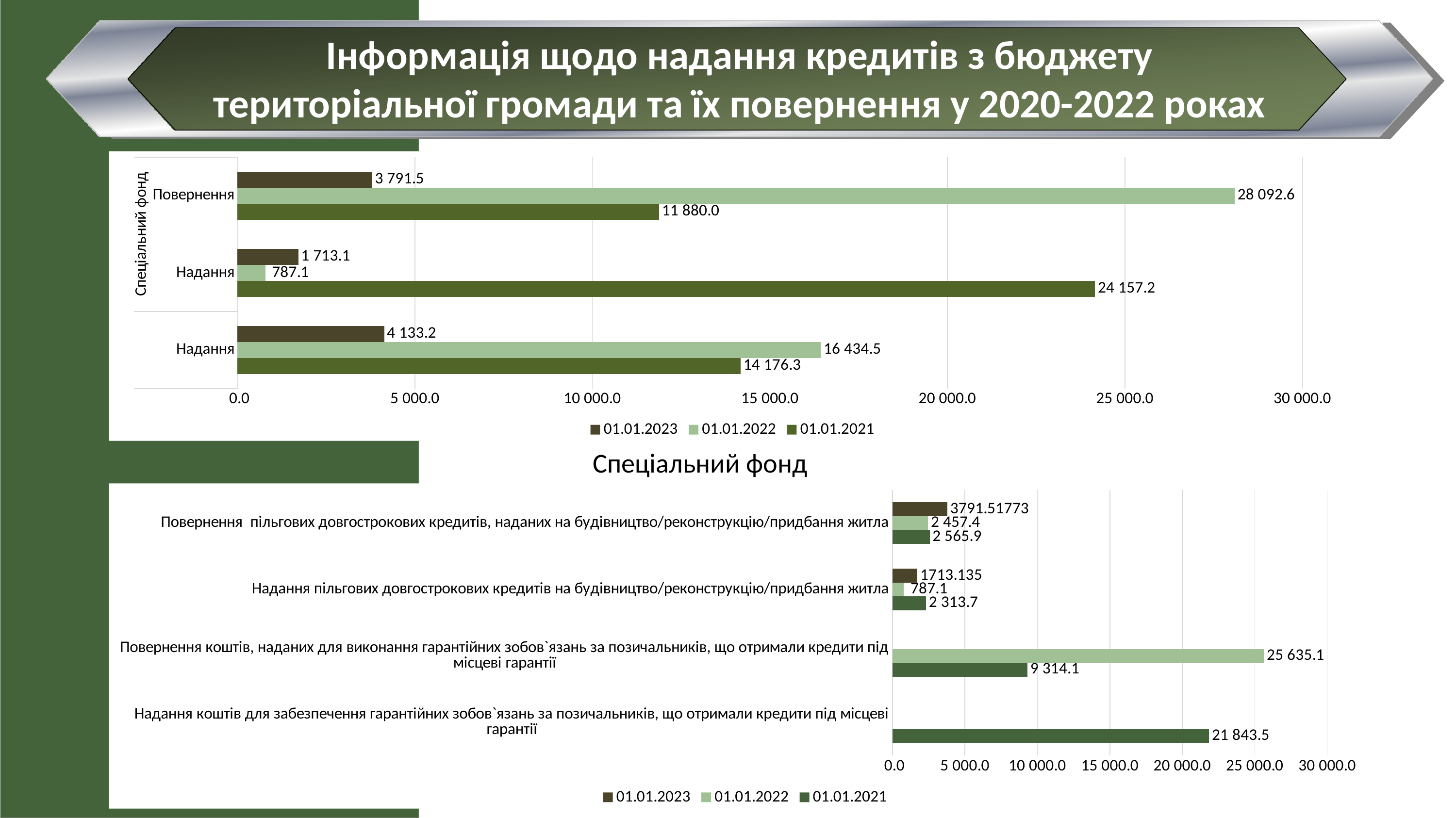
What is the title of the bottom chart? Спеціальний фонд In the bottom chart (Спеціальний фонд), what is the difference between the 01.01.2022 and 01.01.2021 values for Повернення коштів, наданих для виконання гарантійних зобов`язань? 16 321.0 In the bottom chart (Спеціальний фонд), what is the value for Надання коштів для забезпечення гарантійних зобов`язань on 01.01.2021? 21 843.5 What kind of chart is the top chart? bar chart In the top chart, which series has the highest value for Повернення (Спеціальний фонд)? 01.01.2022 In the top chart, how many series does the legend list? 3 In the bottom chart (Спеціальний фонд), what is the value for Повернення коштів, наданих для виконання гарантійних зобов`язань on 01.01.2022? 25 635.1 In the top chart, what is the difference between the 01.01.2022 and 01.01.2021 values for the bottom Надання category? 2 258.2 In the top chart, what is the value for Надання (Спеціальний фонд) on 01.01.2021? 24 157.2 In the bottom chart (Спеціальний фонд), how many categories are shown? 4 In the top chart, what is the value for Повернення (Спеціальний фонд) on 01.01.2022? 28 092.6 In the bottom chart (Спеціальний фонд), which is larger for Повернення пільгових довгострокових кредитів: the 01.01.2022 value or the 01.01.2021 value? 01.01.2021